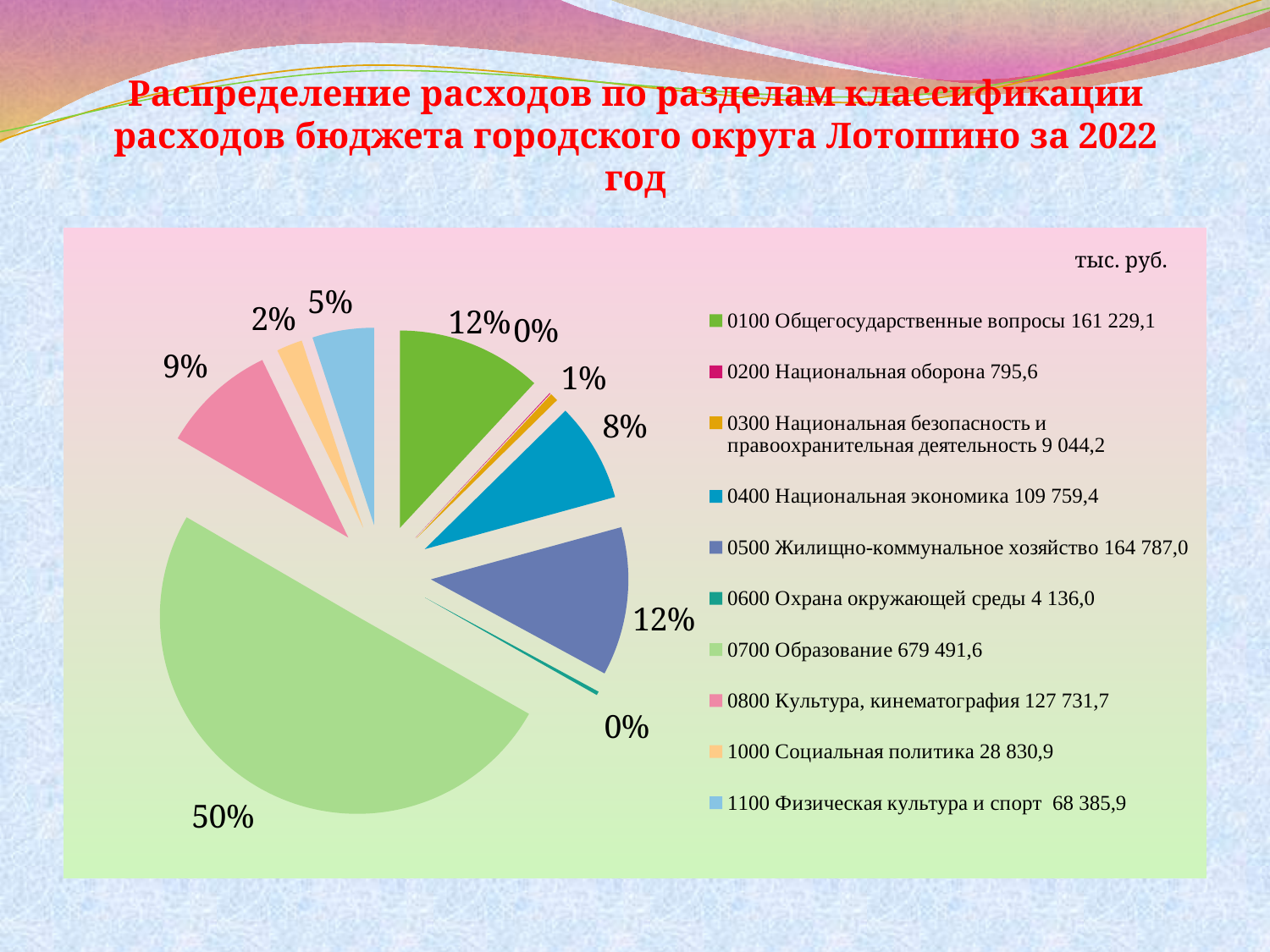
What share of the pie does 0800 Культура, кинематография take? 9% Which is larger: the value for 0400 Национальная экономика or for 0800 Культура, кинематография? 0800 Культура, кинематография How many categories (slices) does the pie chart have? 10 What unit is indicated in the top right corner of the chart area? тыс. руб. What share of the pie does 1100 Физическая культура и спорт take? 5% What value (тыс. руб.) is shown in the legend for 0400 Национальная экономика? 109 759,4 What share of the pie does 0700 Образование take? 50% What value (тыс. руб.) is shown in the legend for 0500 Жилищно-коммунальное хозяйство? 164 787,0 Which category has the smallest value according to the legend? 0200 Национальная оборона What kind of chart is shown on the slide? pie chart Which category has the largest share of the pie? 0700 Образование What value (тыс. руб.) is shown in the legend for 1000 Социальная политика? 28 830,9